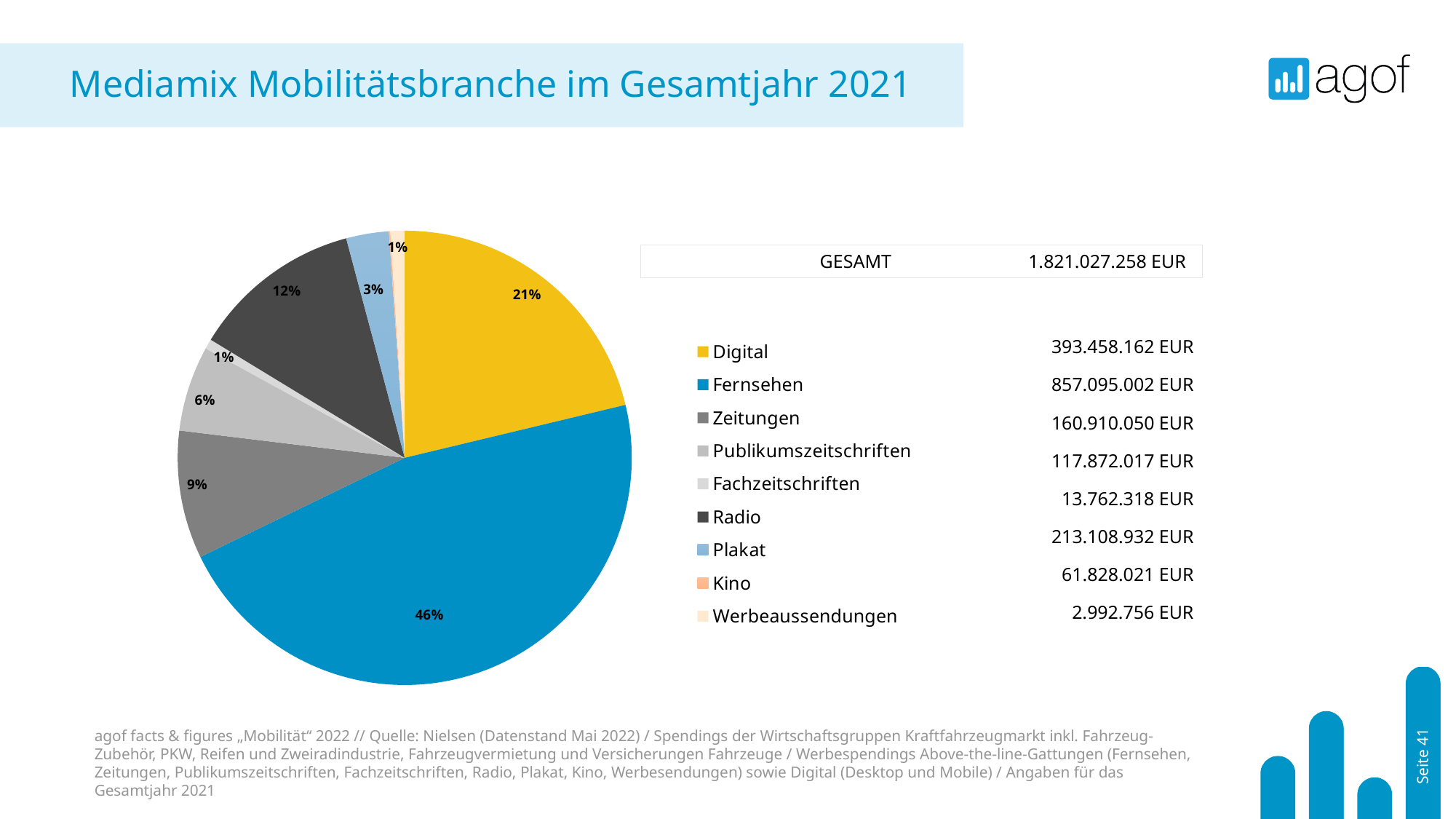
How many categories does the legend of the pie chart list? 9 Which category has the largest slice of the pie? Fernsehen What is the value shown for Fernsehen? 857.095.002 EUR What share of the pie does Radio account for? 12% What share of the pie does Digital account for? 21% What kind of chart is shown on the slide? pie chart Which has the larger share of the pie, Zeitungen or Publikumszeitschriften? Zeitungen What share of the pie does Zeitungen account for? 9% What is the title of the slide? Mediamix Mobilitätsbranche im Gesamtjahr 2021 What is the GESAMT (total) value shown next to the chart? 1.821.027.258 EUR What is the value shown for Digital? 393.458.162 EUR